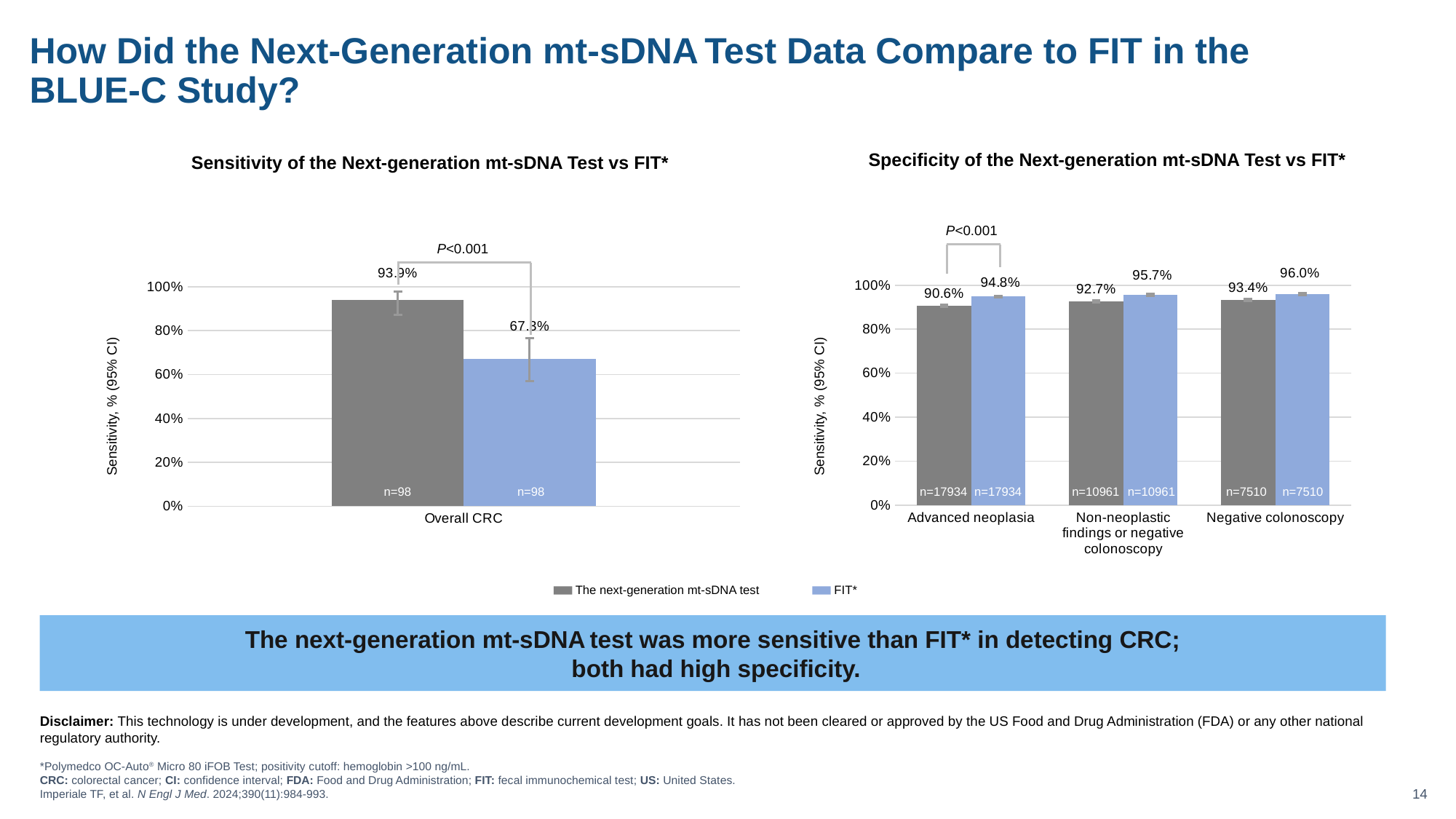
In the Specificity chart, what is the difference between the FIT* value and the next-generation mt-sDNA test value for Advanced neoplasia? 4.2% In the Specificity chart, which bar has the lowest value? The next-generation mt-sDNA test for Advanced neoplasia (90.6%) How many series does the legend list for the charts? 2 In the Sensitivity chart, which test has the larger value for Overall CRC, the next-generation mt-sDNA test or FIT*? The next-generation mt-sDNA test In the Specificity chart, what is the value for FIT* in the Negative colonoscopy category? 96.0% In the Specificity chart, what is the value for FIT* in the Non-neoplastic findings or negative colonoscopy category? 95.7% In the Sensitivity chart, is the value for FIT* in Overall CRC greater or less than 80%? less What kind of chart is the Sensitivity chart on the left? Bar chart In the Specificity chart, what is the value for the next-generation mt-sDNA test in the Advanced neoplasia category? 90.6% In the Specificity chart, do the values for the next-generation mt-sDNA test rise or fall from Advanced neoplasia to Negative colonoscopy? Rise In the Specificity chart, which bar has the highest value? FIT* for Negative colonoscopy (96.0%) How many categories are shown on the x axis of the Specificity chart? 3